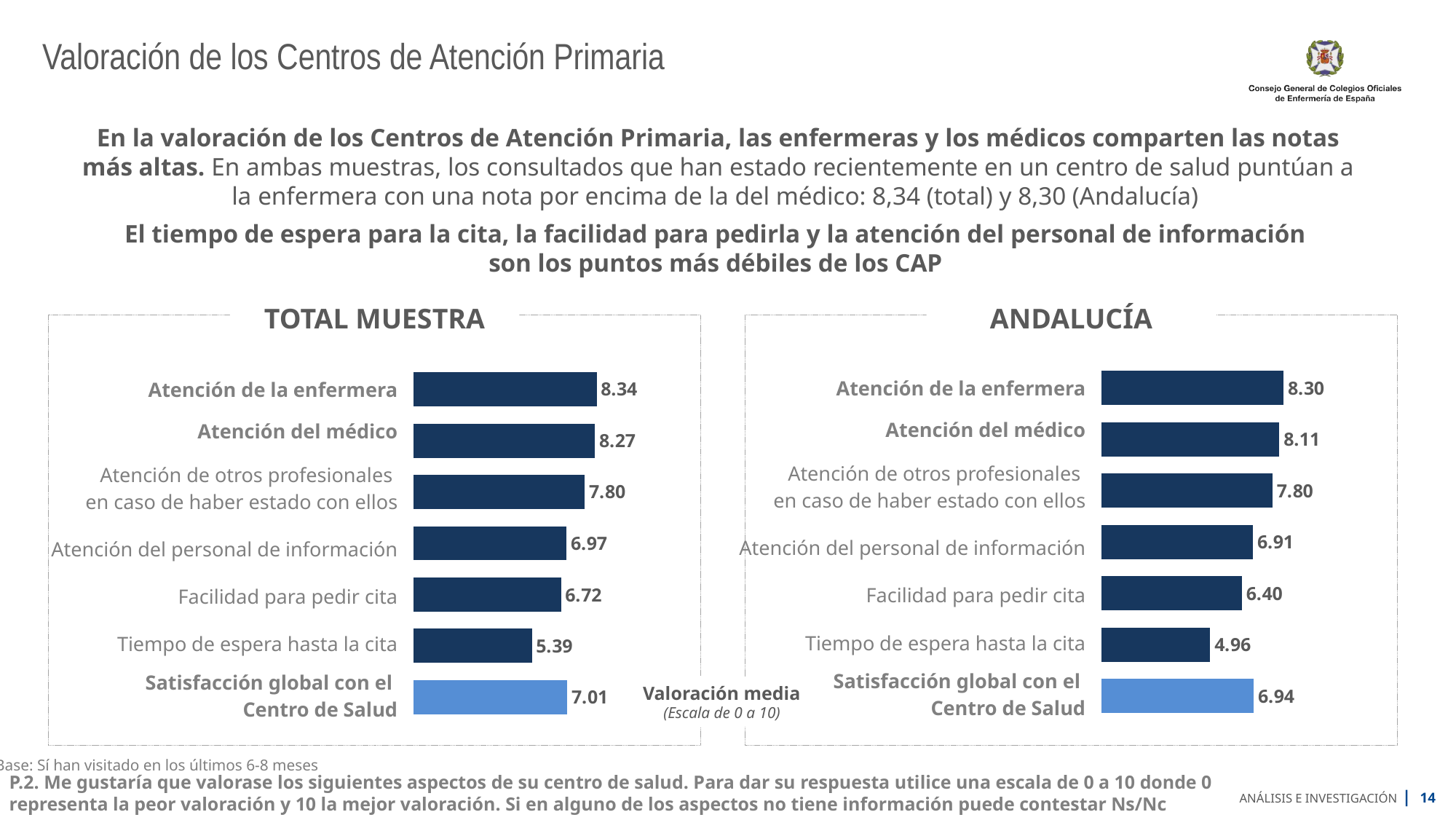
What kind of chart is the ANDALUCÍA chart? Bar chart In the TOTAL MUESTRA chart, which category has the highest value? Atención de la enfermera In the ANDALUCÍA chart, which is larger: Atención del médico or Atención de otros profesionales en caso de haber estado con ellos? Atención del médico In the ANDALUCÍA chart, what is the value for Facilidad para pedir cita? 6.40 In the ANDALUCÍA chart, what is the difference between Atención de la enfermera and Tiempo de espera hasta la cita? 3.34 In the TOTAL MUESTRA chart, what is the value for Atención de la enfermera? 8.34 In the ANDALUCÍA chart, which category has the lowest value? Tiempo de espera hasta la cita Which is larger: Satisfacción global con el Centro de Salud in the TOTAL MUESTRA chart or in the ANDALUCÍA chart? TOTAL MUESTRA In the ANDALUCÍA chart, what is the value for Tiempo de espera hasta la cita? 4.96 In the TOTAL MUESTRA chart, which bar is shown in a lighter blue colour than the others? Satisfacción global con el Centro de Salud In the TOTAL MUESTRA chart, what is the difference between Atención de la enfermera and Atención del médico? 0.07 How many categories does the TOTAL MUESTRA chart show? 7